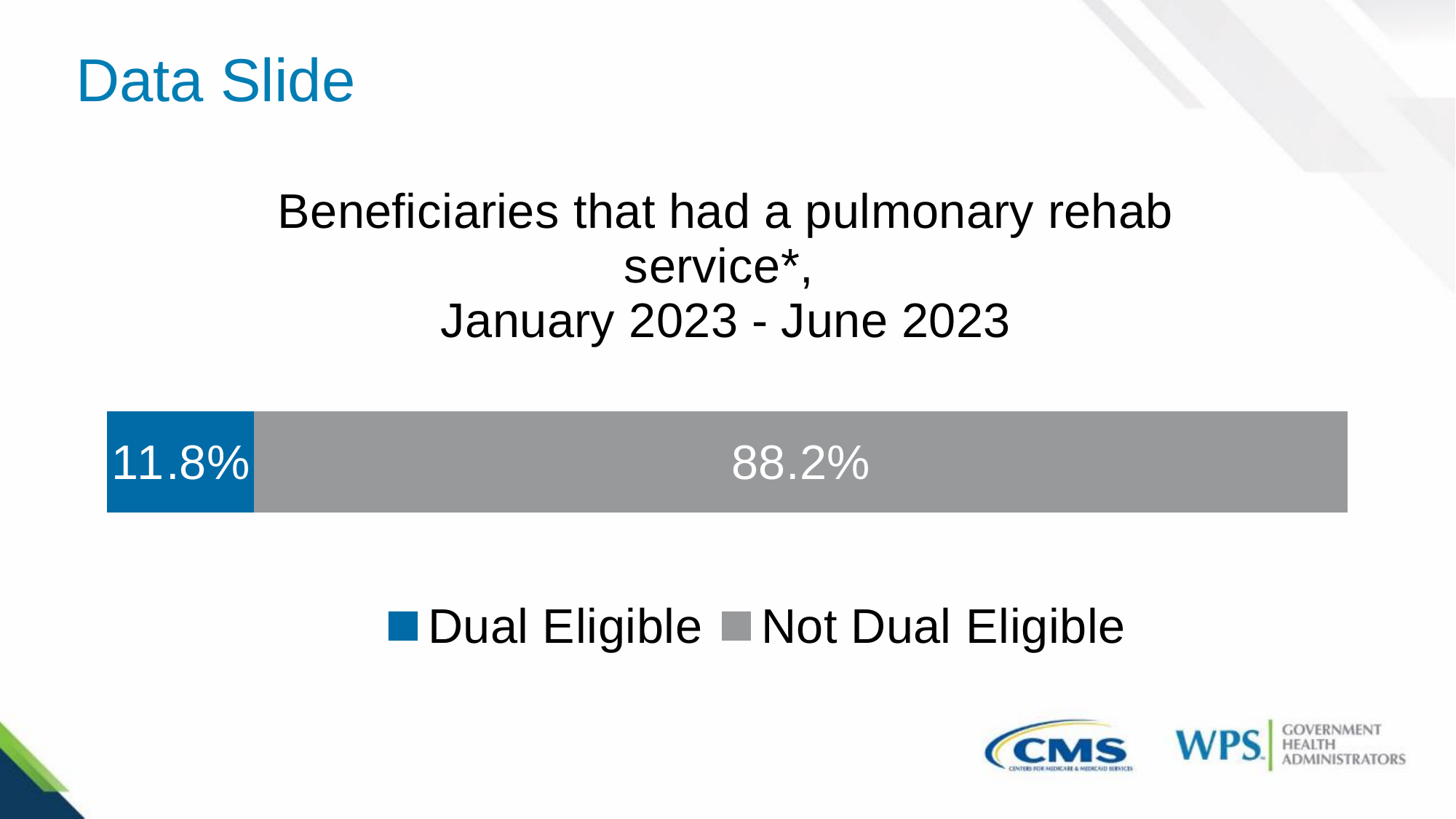
How many series does the legend list? 2 Which series has the largest share in the chart? Not Dual Eligible What percentage of beneficiaries that had a pulmonary rehab service were Dual Eligible? 11.8% What is the total of the two segments in the stacked bar? 100% Which series has the smallest share in the chart? Dual Eligible What colour represents the Dual Eligible series in the chart? Blue What is the title of the chart? Beneficiaries that had a pulmonary rehab service*, January 2023 - June 2023 What is the difference in percentage points between the Not Dual Eligible and Dual Eligible shares? 76.4 What kind of chart is shown on the slide? Stacked bar chart Which series has the larger share: Dual Eligible or Not Dual Eligible? Not Dual Eligible What percentage of beneficiaries that had a pulmonary rehab service were Not Dual Eligible? 88.2%